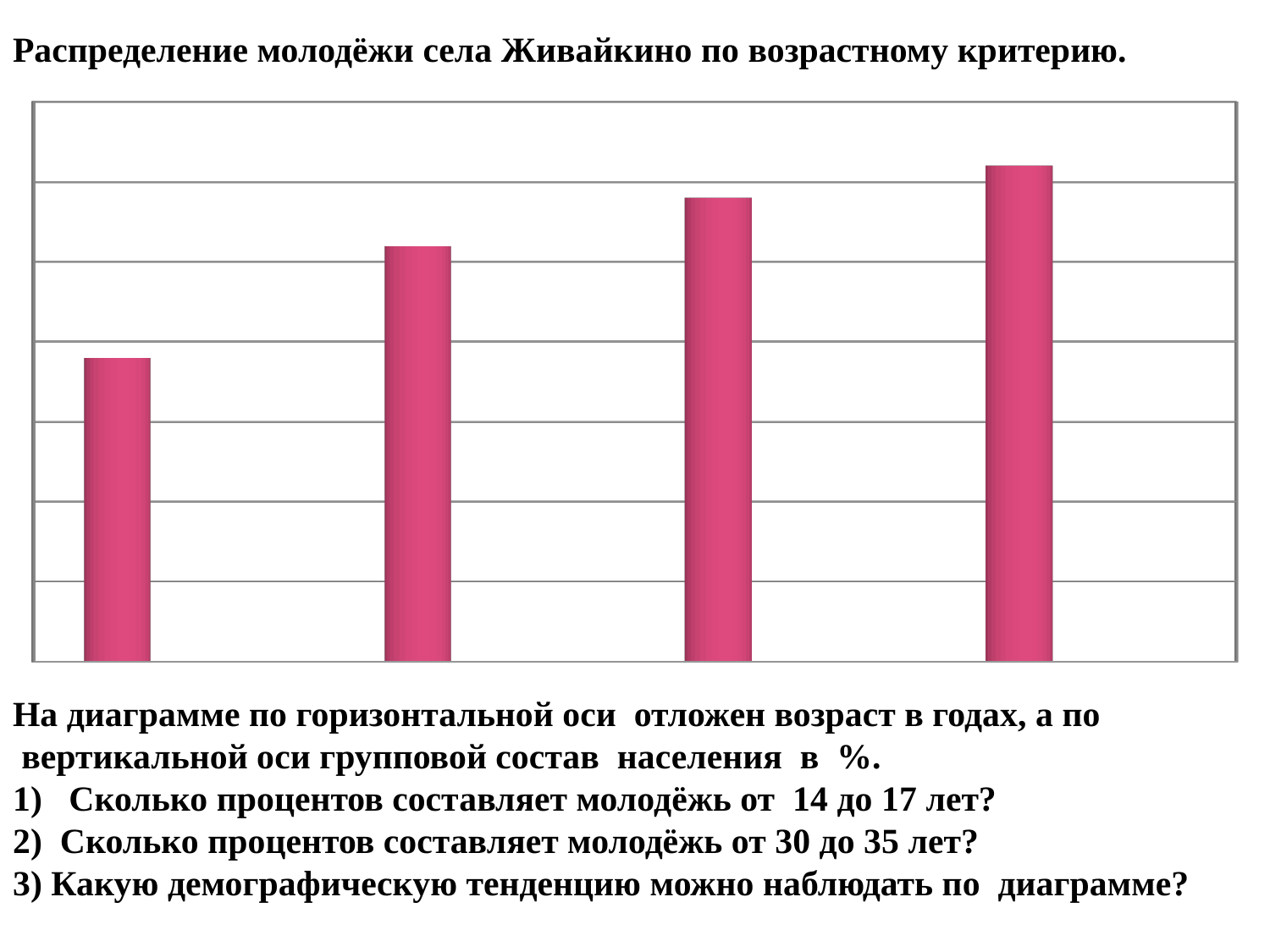
How many bars are plotted in the chart? 4 Which is taller: the third bar from the left or the fourth bar from the left? the fourth bar What colour are the bars in the chart? pink Do the bar heights rise or fall from left to right across the chart? rise What kind of chart is shown on the slide? bar chart Which bar is the tallest in the chart: the first, second, third or fourth from the left? fourth What is the title shown above the chart? Распределение молодёжи села Живайкино по возрастному критерию. Which is taller: the first bar from the left or the second bar from the left? the second bar Which bar is the shortest in the chart: the first, second, third or fourth from the left? first